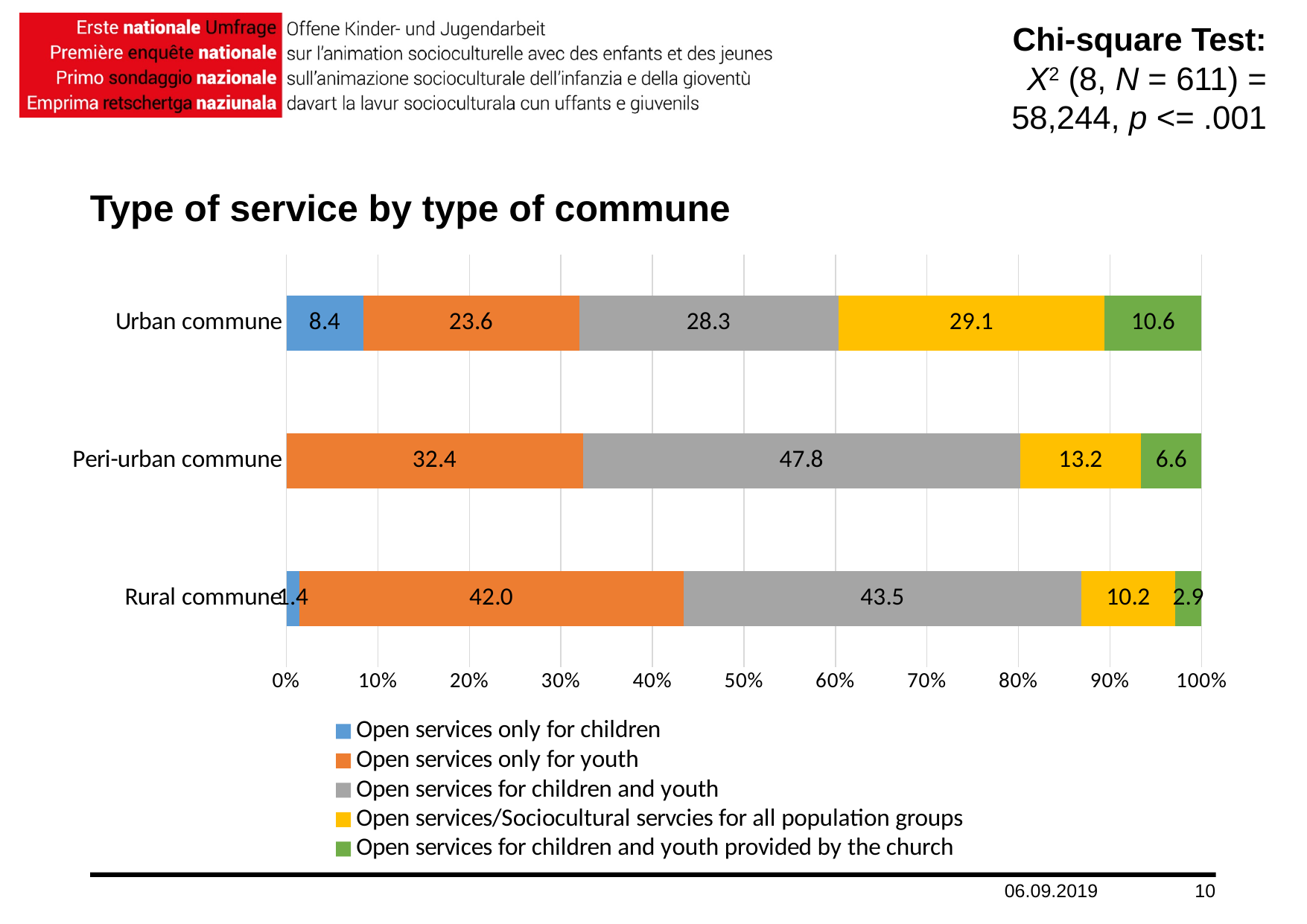
Which type of commune has the lowest value for 'Open services for children and youth provided by the church'? Rural commune Which is larger: 'Open services/Sociocultural servcies for all population groups' in the Peri-urban commune or in the Rural commune? Peri-urban commune What is the value for 'Open services for children and youth provided by the church' in the Peri-urban commune? 6.6 How many series does the legend list? 5 What is the value for 'Open services for children and youth' in the Peri-urban commune? 47.8 What is the title of the chart? Type of service by type of commune What is the value for 'Open services only for youth' in the Rural commune? 42.0 What kind of chart is shown on the slide? Stacked bar chart What is the difference between 'Open services for children and youth' and 'Open services only for youth' in the Peri-urban commune? 15.4 Which type of commune has the highest value for 'Open services for children and youth'? Peri-urban commune What is the value for 'Open services only for children' in the Urban commune? 8.4 How many types of commune are shown on the chart? 3